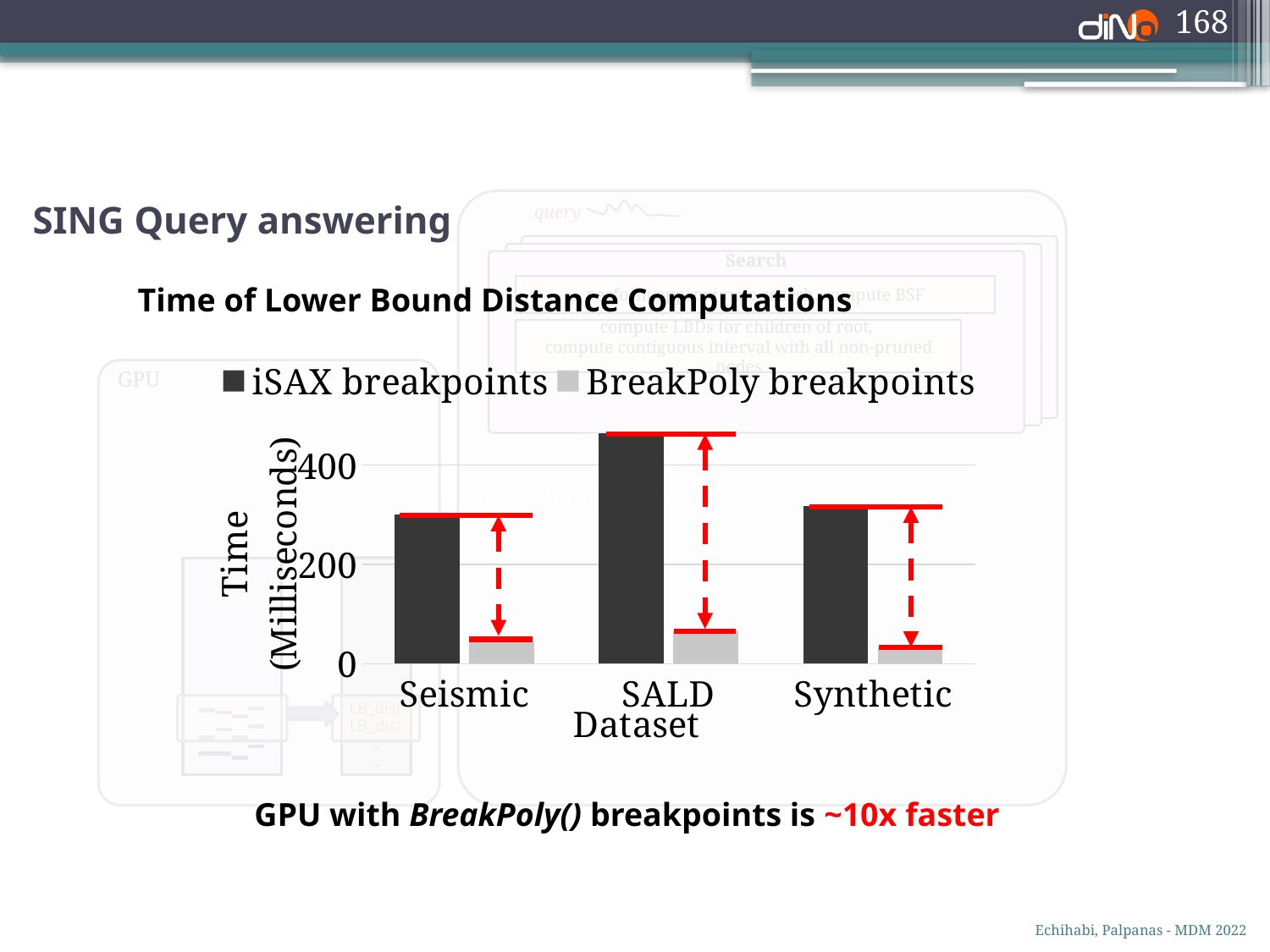
Which dataset has the highest BreakPoly breakpoints time? SALD What is the title of the chart? Time of Lower Bound Distance Computations What is the label of the x axis of the chart? Dataset What kind of chart is shown on the slide? bar chart Is the iSAX breakpoints time for Synthetic greater or less than 400? less How many series does the chart legend list? 2 How many datasets are shown on the x axis of the chart? 3 Which dataset has the highest iSAX breakpoints time? SALD Is the BreakPoly breakpoints time for SALD greater or less than 200? less For the Seismic dataset, which is larger: the iSAX breakpoints time or the BreakPoly breakpoints time? iSAX breakpoints Is the iSAX breakpoints time for SALD greater or less than 400? greater